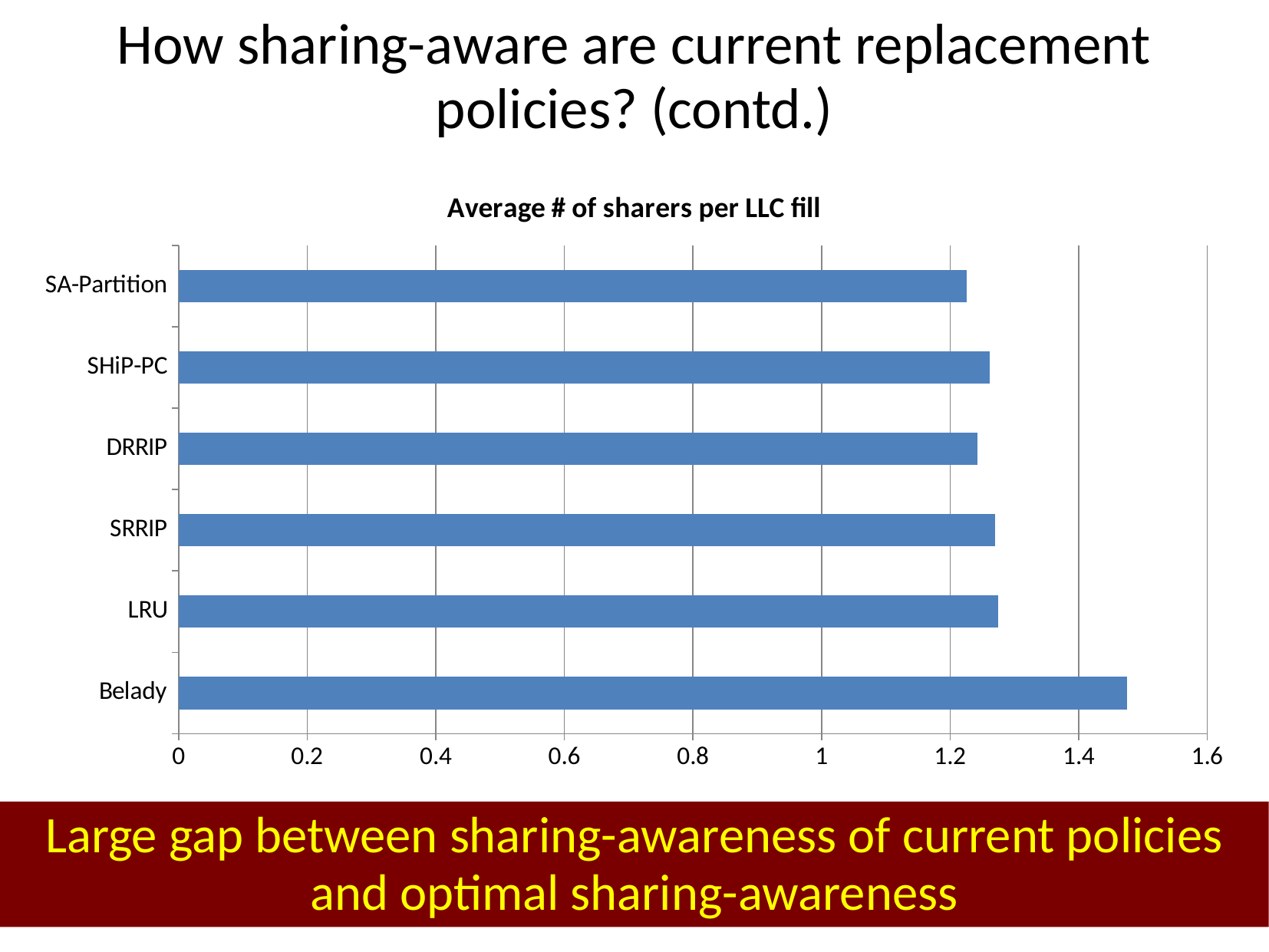
What is the maximum value shown on the horizontal axis? 1.6 Which policy has the highest average number of sharers per LLC fill? Belady Is the value for LRU greater or less than 1.4? less Which has a larger value, Belady or LRU? Belady What is the title of the chart? Average # of sharers per LLC fill How many replacement policies are plotted in the chart? 6 Is the value for SHiP-PC greater or less than 1.4? less Which has a larger value, SA-Partition or Belady? Belady Is the value for SA-Partition greater or less than 1.2? greater What kind of chart is shown on the slide? bar chart